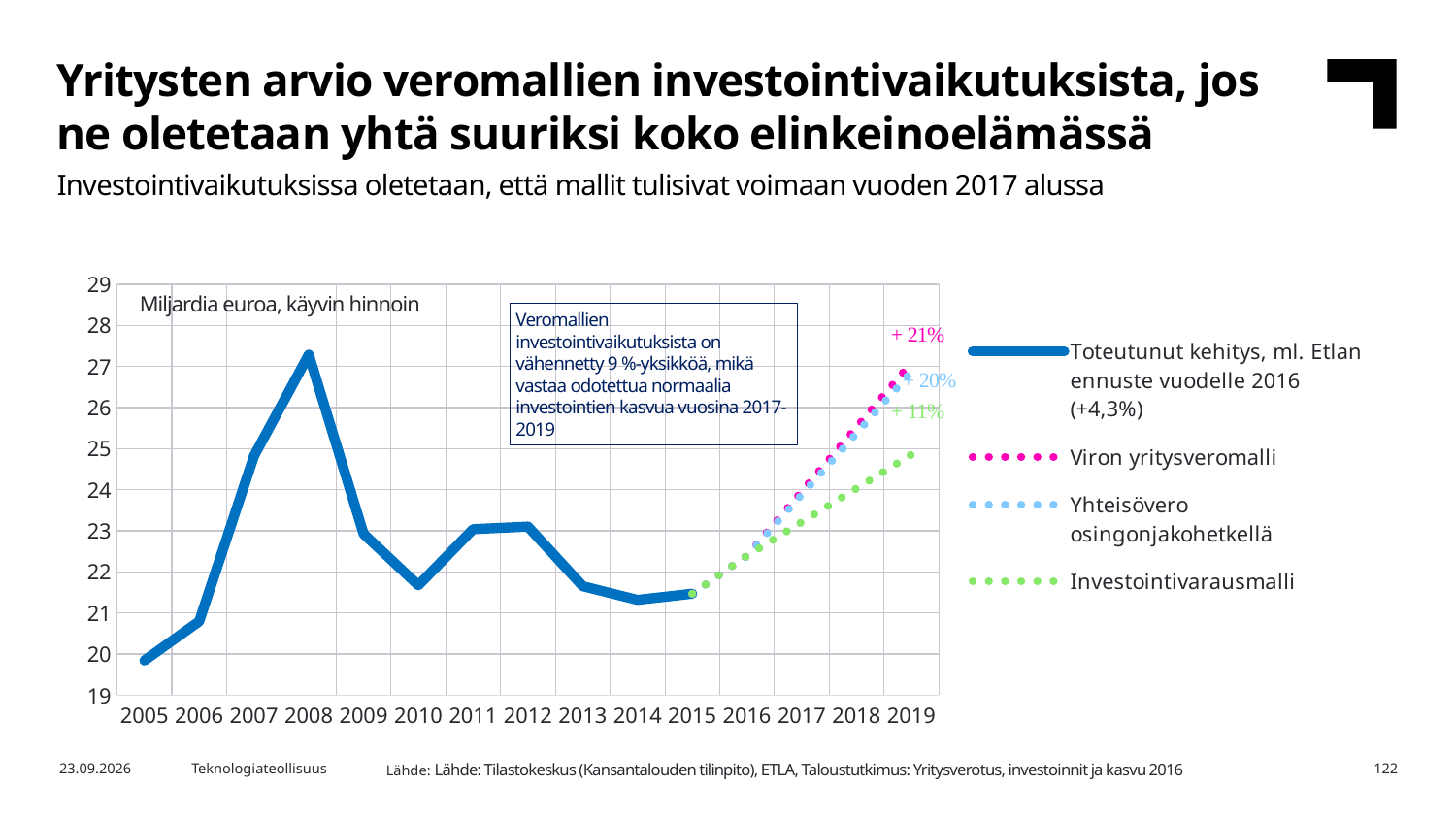
What percentage label is printed next to the end of the 'Viron yritysveromalli' series? + 21% In which year does the solid line 'Toteutunut kehitys' have its lowest value? 2005 Is the value of the solid line in 2014 greater or less than 22? less How many years are shown on the x axis? 15 In which year does the solid line 'Toteutunut kehitys' reach its highest value? 2008 Does the solid line rise or fall between 2008 and 2009? Fall Which is larger, the solid line's value in 2008 or in 2009? 2008 Is the value of the solid line in 2008 greater or less than 26? greater How many series does the legend list? 4 Is the value of the solid line in 2005 greater or less than 20? less What kind of chart is shown on the slide? Line chart Which dotted series ends highest in 2019? Viron yritysveromalli